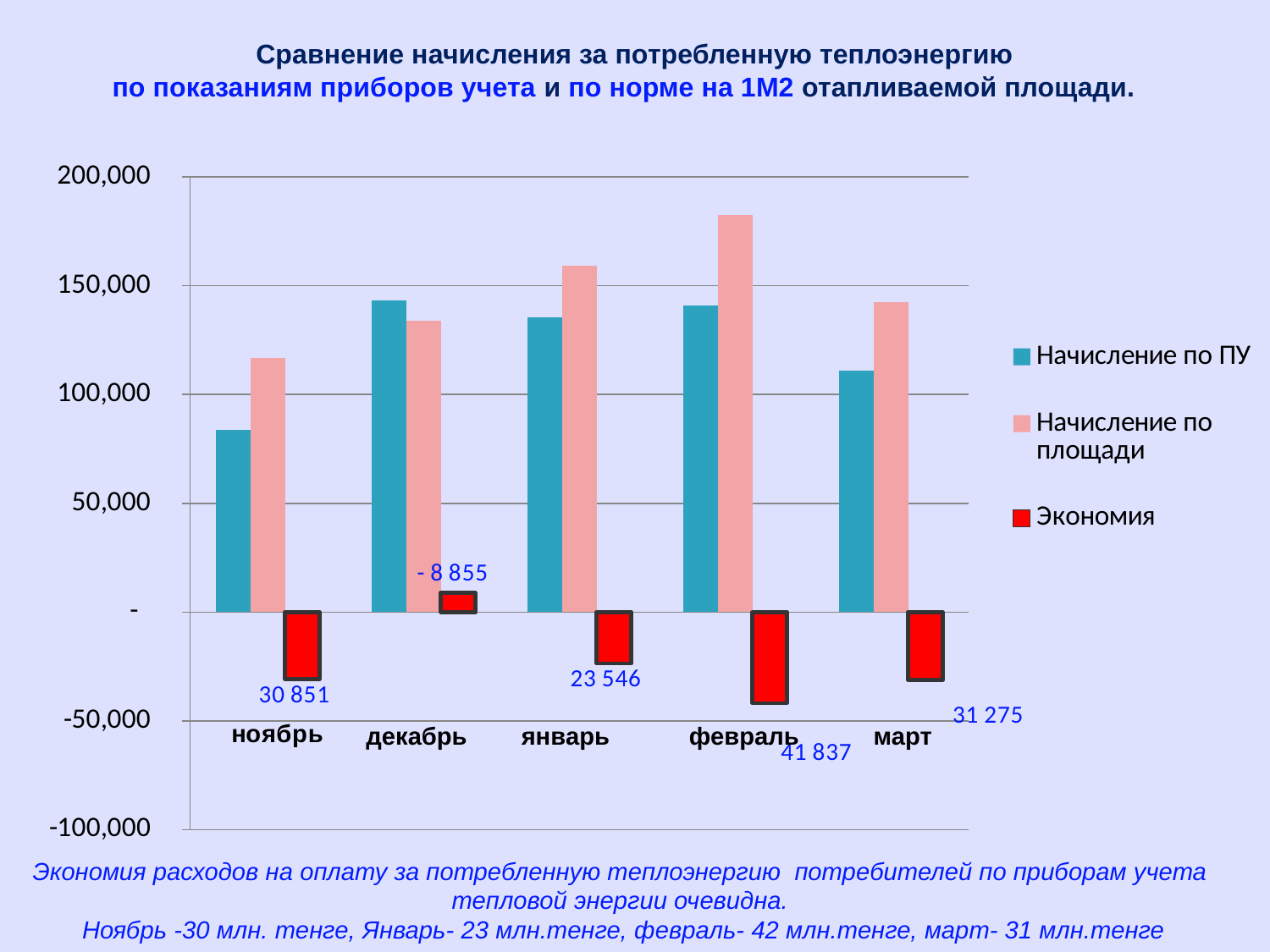
What is the value of Экономия for январь? 23 546 How many series does the legend list? 3 Which month has the highest Начисление по площади bar? февраль What is the value of Экономия for февраль? 41 837 Is the value of Начисление по ПУ for ноябрь greater or less than 100,000? less Is the value of Начисление по площади for февраль greater or less than 150,000? greater What is the difference between the Экономия values for февраль and ноябрь? 10 986 What is the value of Экономия for декабрь? - 8 855 How many months are shown on the x axis? 5 In декабрь, which is larger: Начисление по ПУ or Начисление по площади? Начисление по ПУ